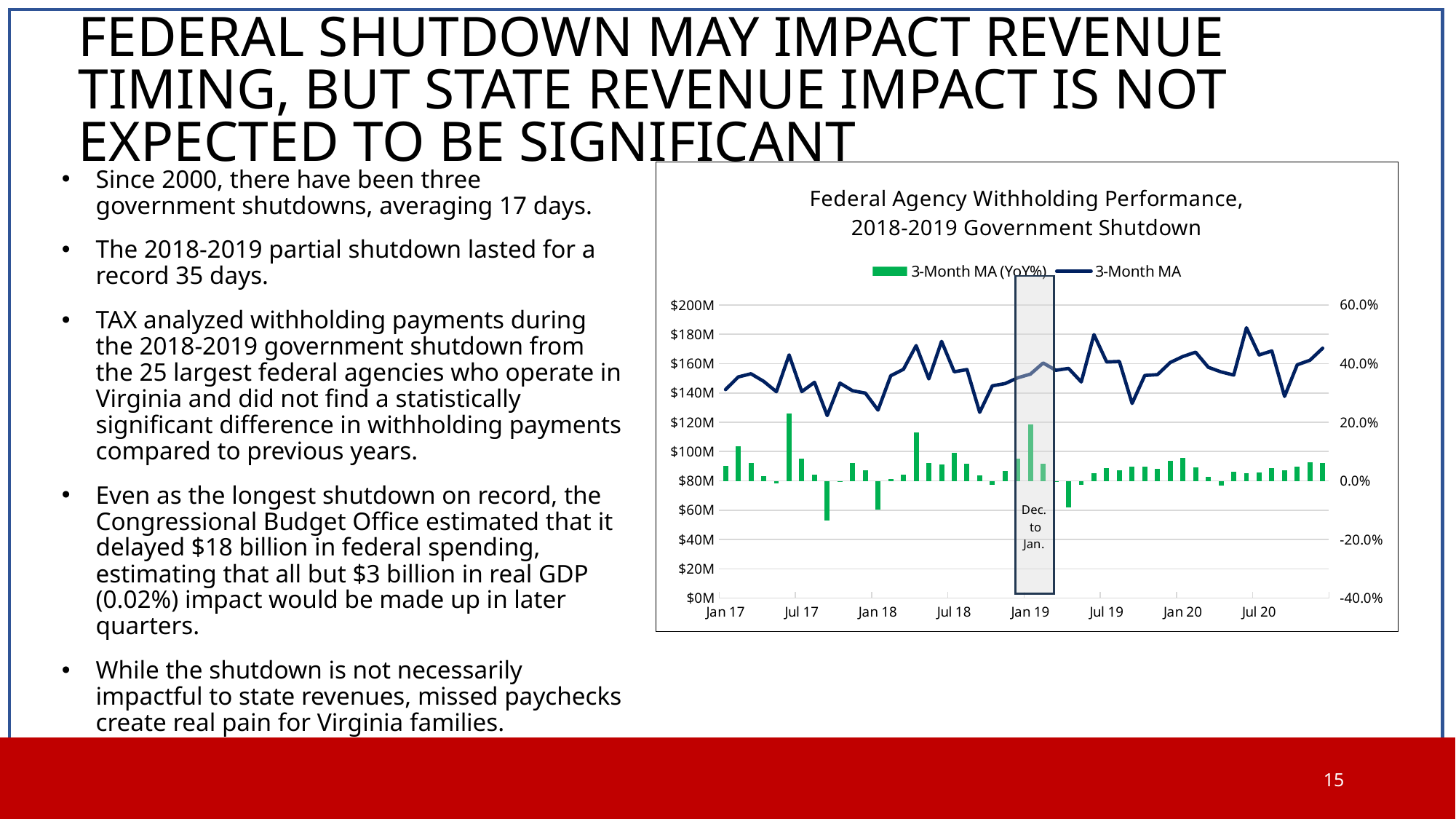
What is the lowest value shown on the right axis of the chart? -40.0% What is the title of the chart? Federal Agency Withholding Performance, 2018-2019 Government Shutdown Does the 3-Month MA line end higher or lower at the right of the chart than it starts at Jan 17? higher Is the 3-Month MA line value at Jan 19 greater or less than $100M? greater How many labelled tick marks are on the x axis of the chart? 8 Which series is drawn as green bars? 3-Month MA (YoY%) What is the highest value shown on the left axis of the chart? $200M Is the 3-Month MA line value at Jan 17 greater or less than $120M? greater What period does the shaded box on the chart mark? Dec. to Jan. What kind of chart is shown on the slide? Combined bar and line chart How many series does the chart legend list? 2 Is the 3-Month MA line value at Jul 20 greater or less than $140M? greater